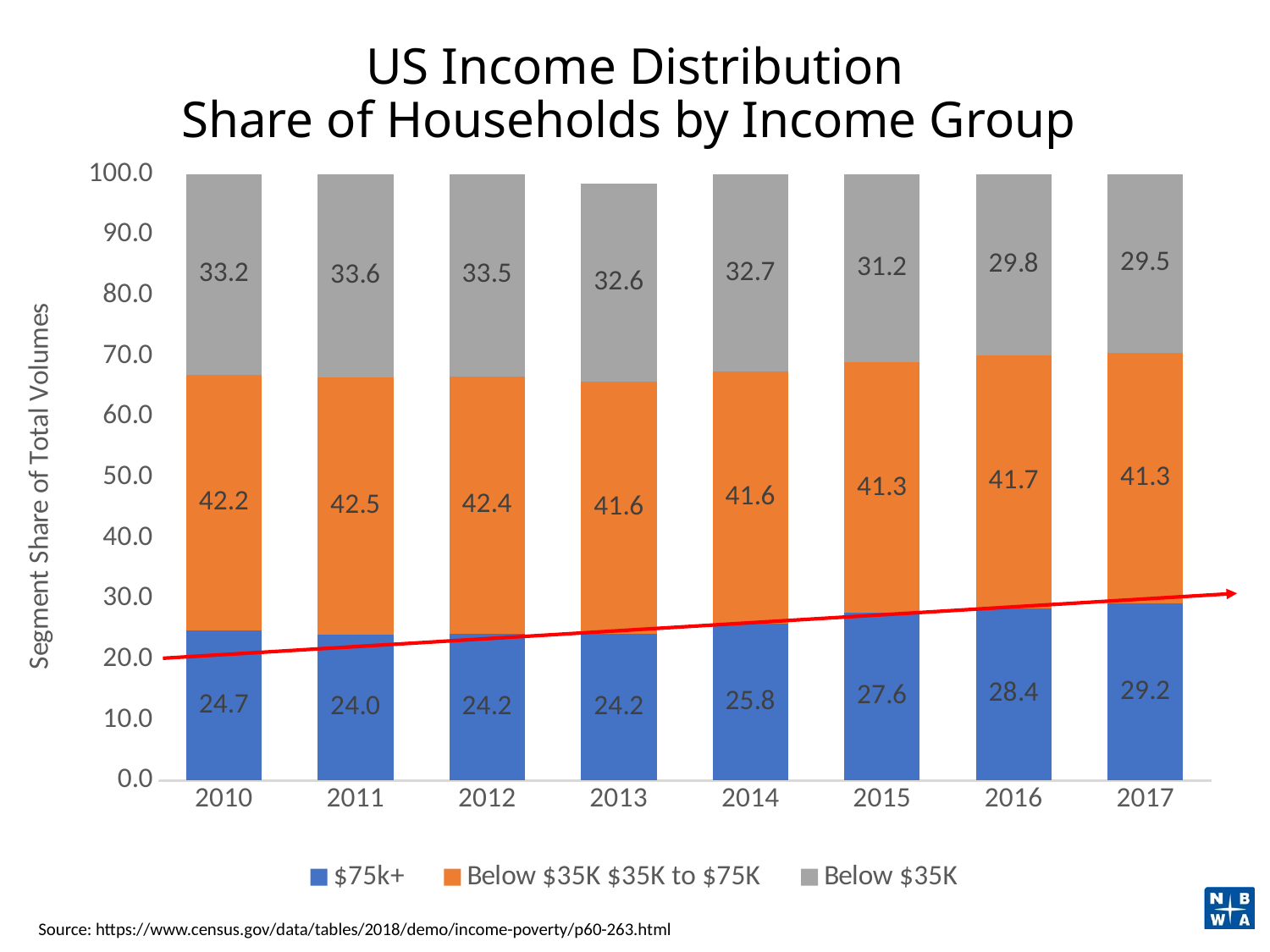
What is the value of the orange segment (middle income group) in 2011? 42.5 Which is larger, the Below $35K value in 2010 or in 2016? 2010 How many years are shown on the x axis? 8 In which year is the Below $35K share lowest? 2017 What is the value for Below $35K in 2013? 32.6 Does the $75k+ share rise or fall from 2013 to 2017? Rise What is the total of the stacked bar for 2013? 98.4 How many series does the legend list? 3 What is the difference between the $75k+ value in 2017 and in 2010? 4.5 What is the value for $75k+ in 2017? 29.2 In which year is the $75k+ share highest? 2017 What kind of chart is shown on the slide? Stacked bar chart